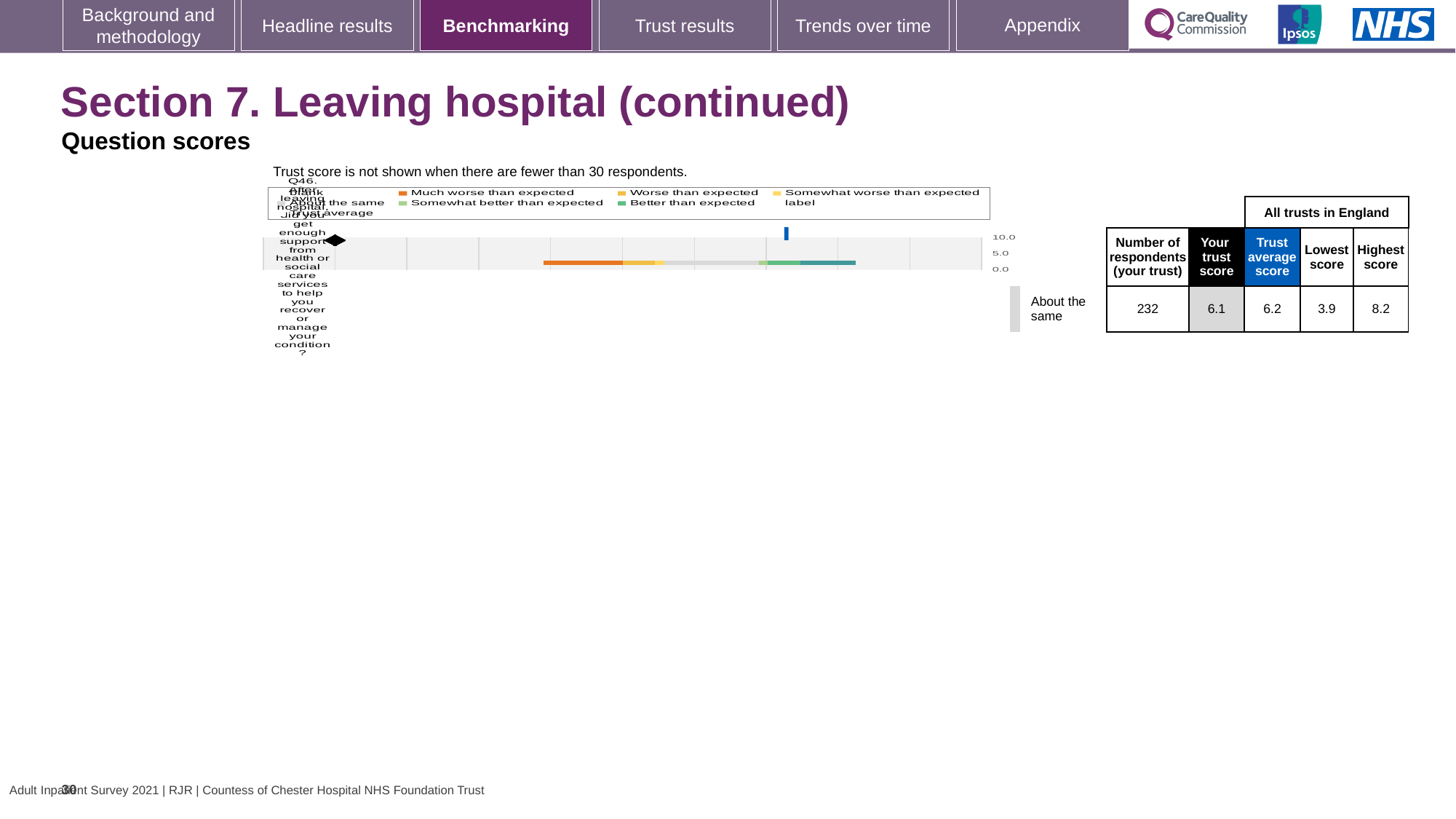
What is your trust's score for Q46? 6.1 Is your trust's score for Q46 greater or less than 5.0? greater How many respondents from your trust answered Q46 about getting enough support from health or social care services after leaving hospital? 232 What kind of chart is used to show the Q46 benchmarking result? Bar chart How is your trust's Q46 result categorised relative to expectations? About the same What is the highest score among all trusts in England for Q46? 8.2 What is the difference between the highest and lowest scores among all trusts in England for Q46? 4.3 What colour represents 'Much worse than expected' in the chart legend? Orange Which is larger for Q46: your trust score or the trust average score? Trust average score By how much does the trust average score exceed your trust's score for Q46? 0.1 What is the trust average score across all trusts in England for Q46? 6.2 What is the lowest score among all trusts in England for Q46? 3.9